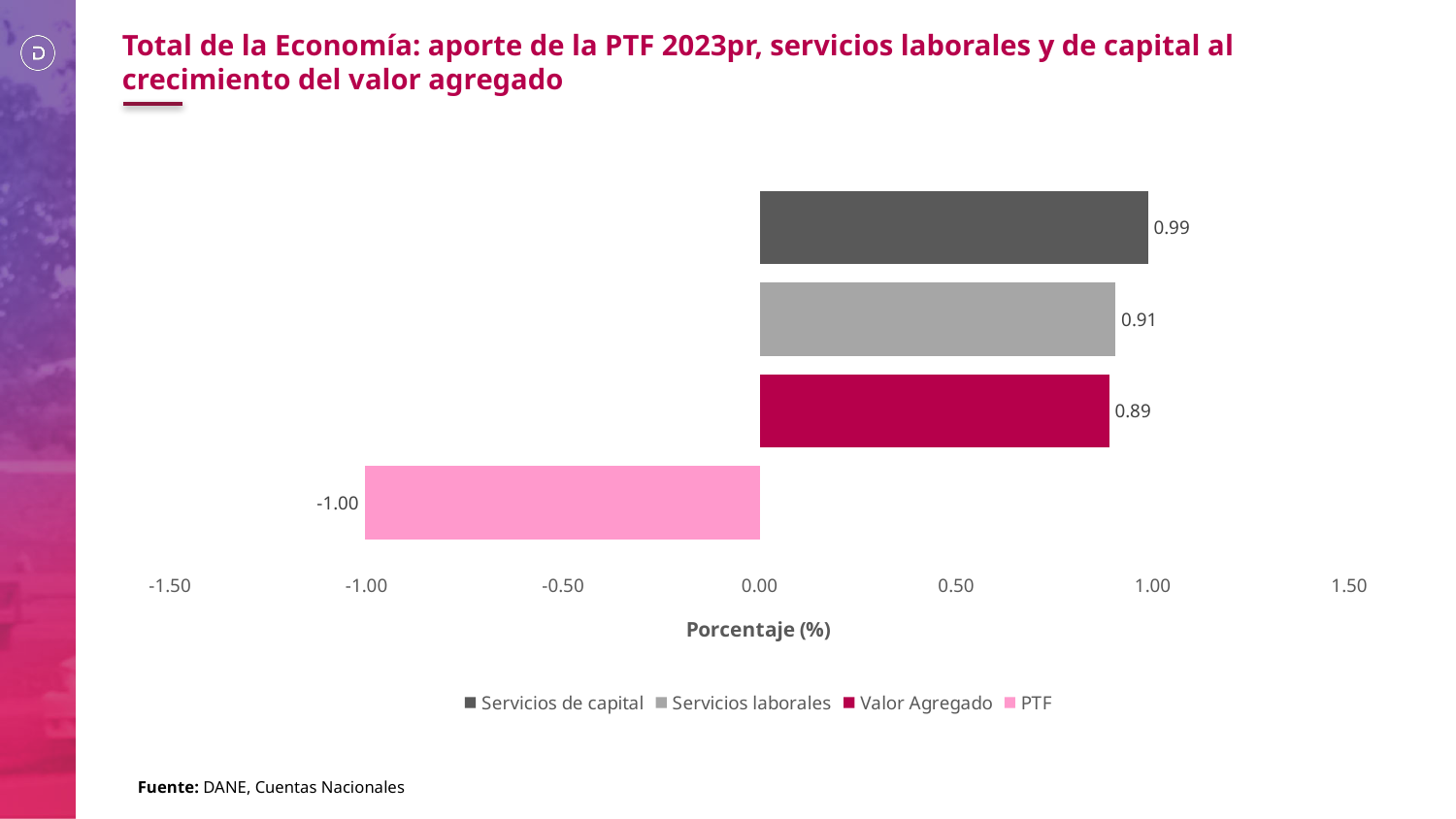
How many series does the legend list? 4 What is the difference between the values for Servicios de capital and Valor Agregado? 0.10 What is the difference between the values for Servicios laborales and PTF? 1.91 Which series has the highest value? Servicios de capital What is the value for Valor Agregado? 0.89 Which series has the lowest value? PTF What is the label of the horizontal axis? Porcentaje (%) What is the value for PTF? -1.00 Which is larger, the value for Servicios laborales or the value for Valor Agregado? Servicios laborales What kind of chart is shown on the slide? Bar chart What is the value for Servicios de capital? 0.99 What is the value for Servicios laborales? 0.91